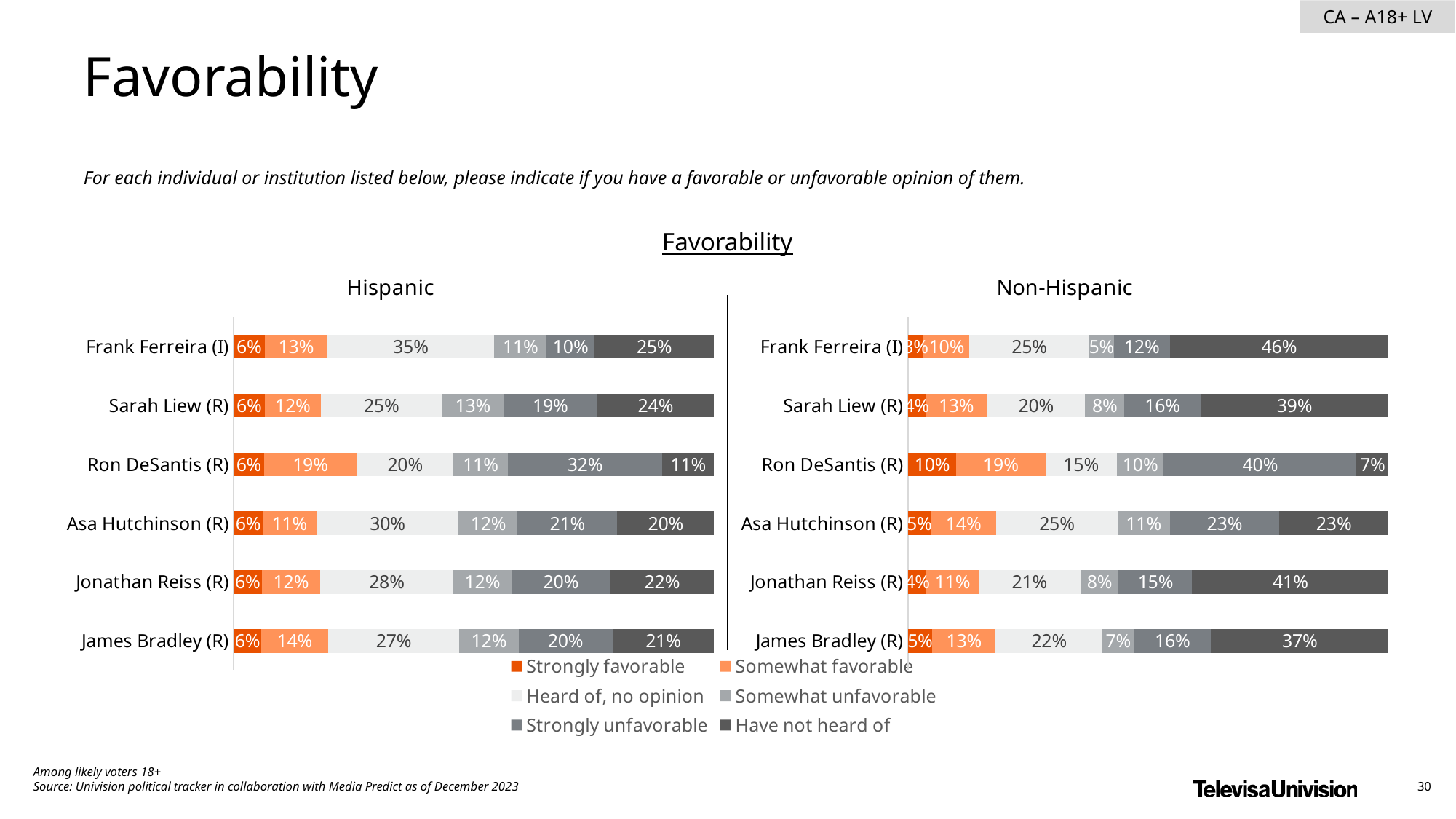
In the Hispanic chart, what is the 'Heard of, no opinion' value for Asa Hutchinson (R)? 30% In the Hispanic chart, what percentage of respondents said they have not heard of Frank Ferreira (I)? 25% How many candidates are listed in the Hispanic chart? 6 In the Non-Hispanic chart, what is the 'Have not heard of' value for Jonathan Reiss (R)? 41% In the Non-Hispanic chart, which candidate has the highest 'Strongly favorable' value? Ron DeSantis (R) In the Non-Hispanic chart, what is the 'Strongly unfavorable' value for Ron DeSantis (R)? 40% How many series does the legend list for the favorability charts? 6 In the Hispanic chart, which candidate has the lowest 'Have not heard of' value? Ron DeSantis (R) Is the 'Somewhat favorable' value for Ron DeSantis (R) larger in the Hispanic chart or the Non-Hispanic chart? They are equal (19%) In the Hispanic chart, what is the difference between the 'Strongly unfavorable' values for Ron DeSantis (R) and Frank Ferreira (I)? 22% In the Non-Hispanic chart, is the 'Have not heard of' value larger for Sarah Liew (R) or James Bradley (R)? Sarah Liew (R) In the Non-Hispanic chart, which candidate has the highest 'Have not heard of' value? Frank Ferreira (I)